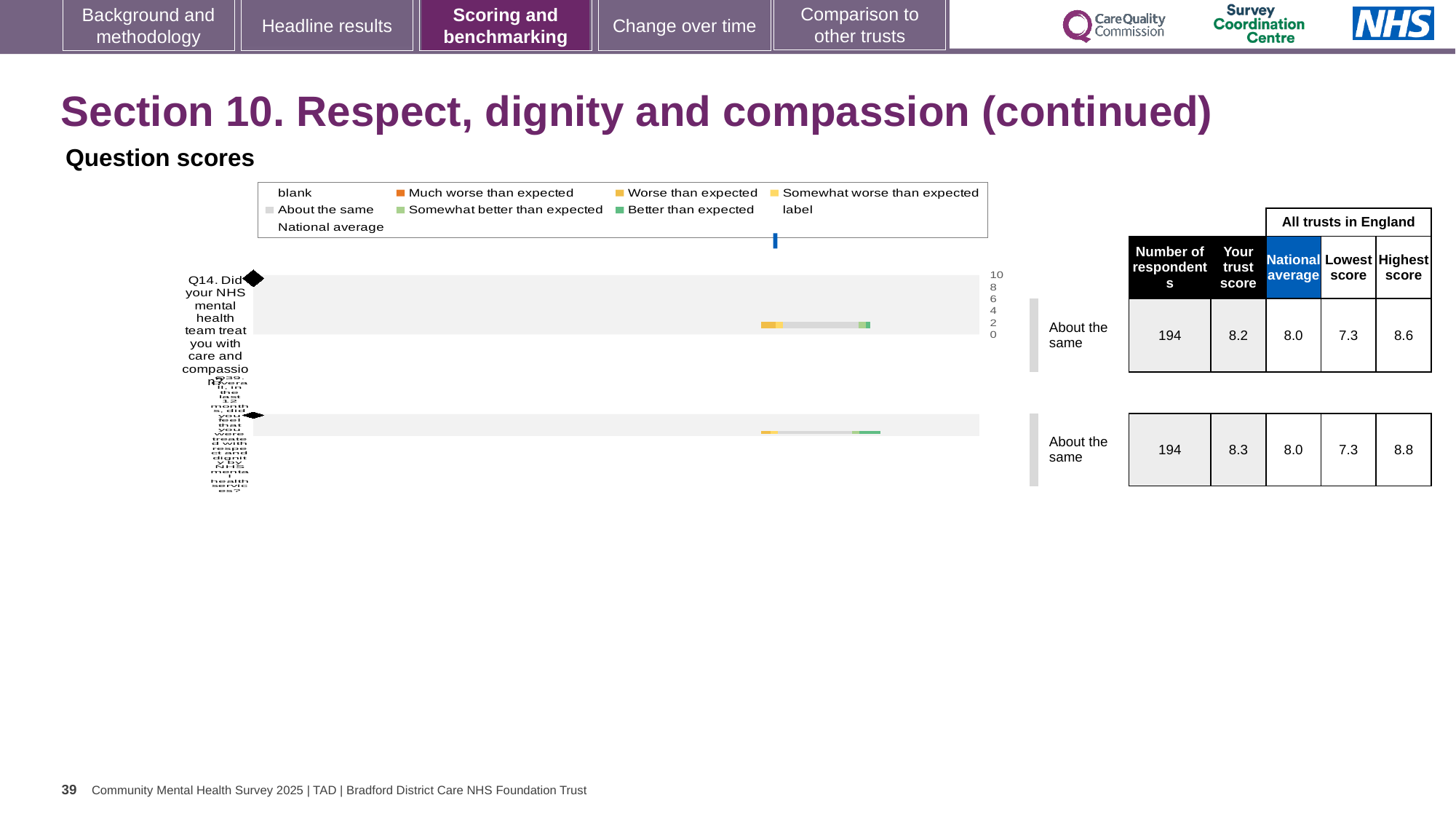
What is the highest score among all trusts in England for Q39? 8.8 How many questions are plotted in the question scores chart? 2 What is the difference between the highest and lowest scores for Q39? 1.5 By how much does the trust score for Q14 exceed the national average for Q14? 0.2 What is the trust score for Q14 (care and compassion)? 8.2 What is the national average score for Q14? 8.0 What benchmark category is shown next to the chart for Q14? About the same Which question has the higher trust score, Q14 or Q39? Q39 How many respondents answered Q14? 194 What is the trust score for Q39 (respect and dignity)? 8.3 What kind of chart is used to show the question scores on this slide? bar chart What is the lowest score among all trusts in England for Q14? 7.3